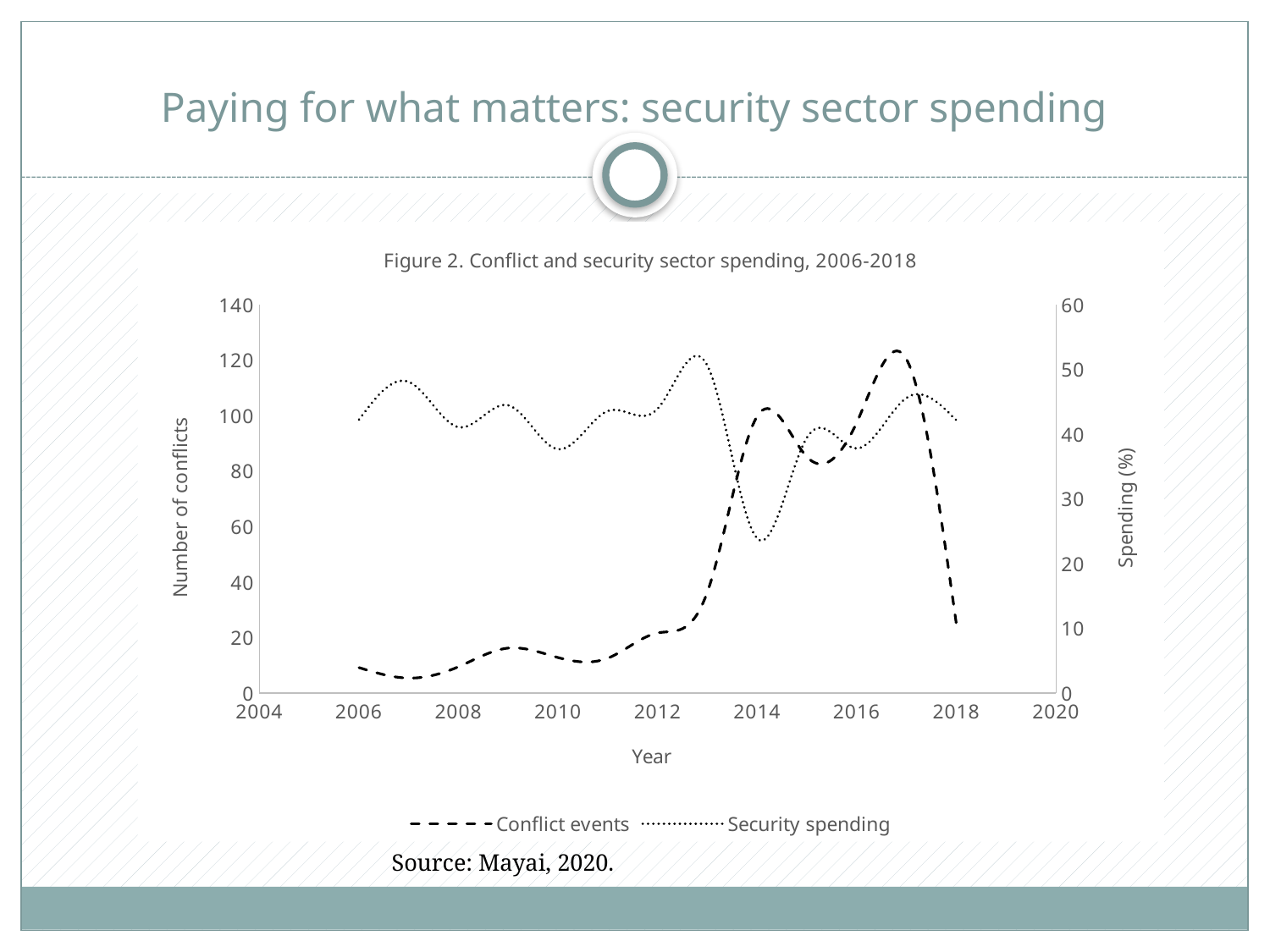
Is the value for Conflict events in 2017 greater or less than 100? greater In which year do Conflict events reach their highest value? 2017 What is the title of the figure? Figure 2. Conflict and security sector spending, 2006-2018 Is the value for Conflict events in 2006 greater or less than 20? less Is the value for Security spending in 2014 greater or less than 30? less Do Conflict events rise or fall overall between 2006 and 2017? rise In which year is Security spending at its lowest? 2014 What kind of chart is shown on the slide? line chart What is the label of the right-hand vertical axis? Spending (%) How many series does the legend list? 2 Which is larger: Conflict events in 2017 or Conflict events in 2006? 2017